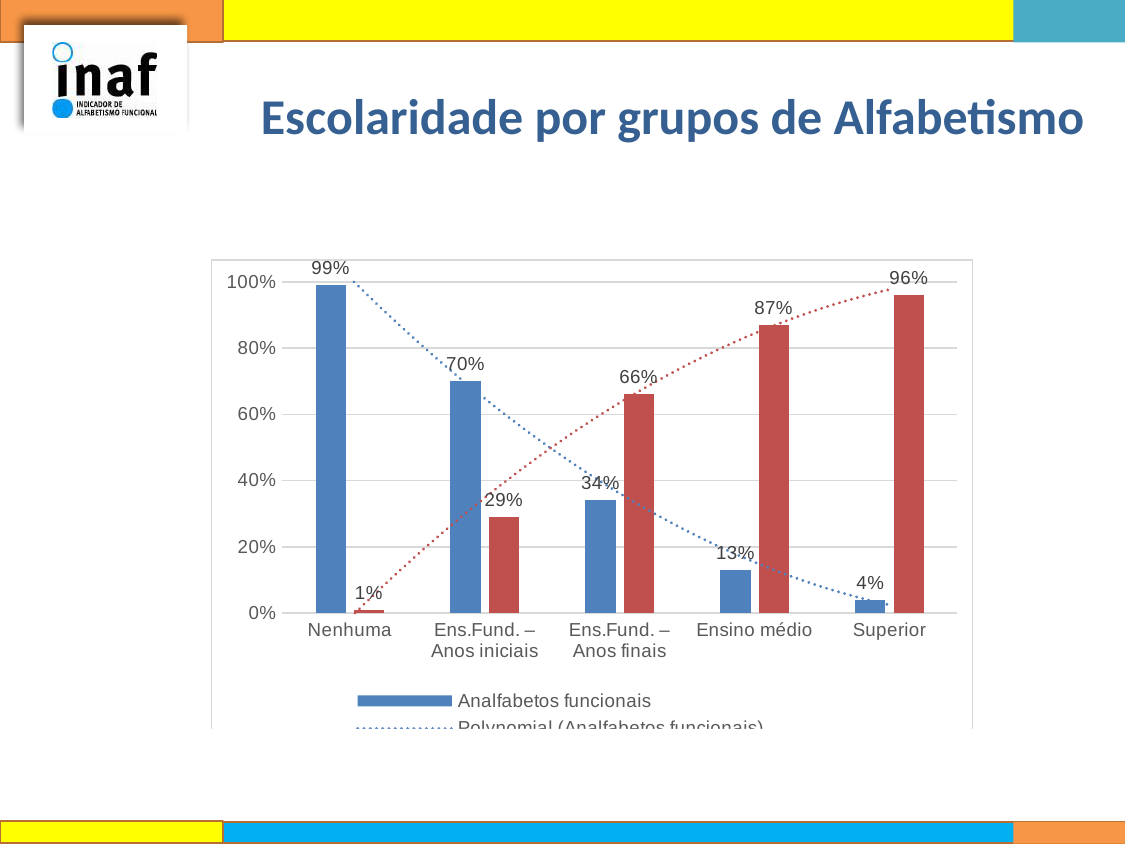
How many education categories are shown on the x axis? 5 Which category has the lowest value for Analfabetos funcionais? Superior Which category has the highest red bar? Superior For Ens.Fund. – Anos finais, which is larger: the blue bar (Analfabetos funcionais) or the red bar? The red bar Do the Analfabetos funcionais values rise or fall from Nenhuma to Superior? Fall What is the difference between the Analfabetos funcionais values for Nenhuma and Superior? 95 percentage points What kind of chart is shown on the slide? Bar chart What is the value of the red bar for Ens.Fund. – Anos iniciais? 29% What is the value of the red bar for the Superior category? 96% Is the value of Analfabetos funcionais for Ensino médio greater or less than 20%? less Which category has the highest value for Analfabetos funcionais? Nenhuma What is the value of Analfabetos funcionais for the Nenhuma category? 99%